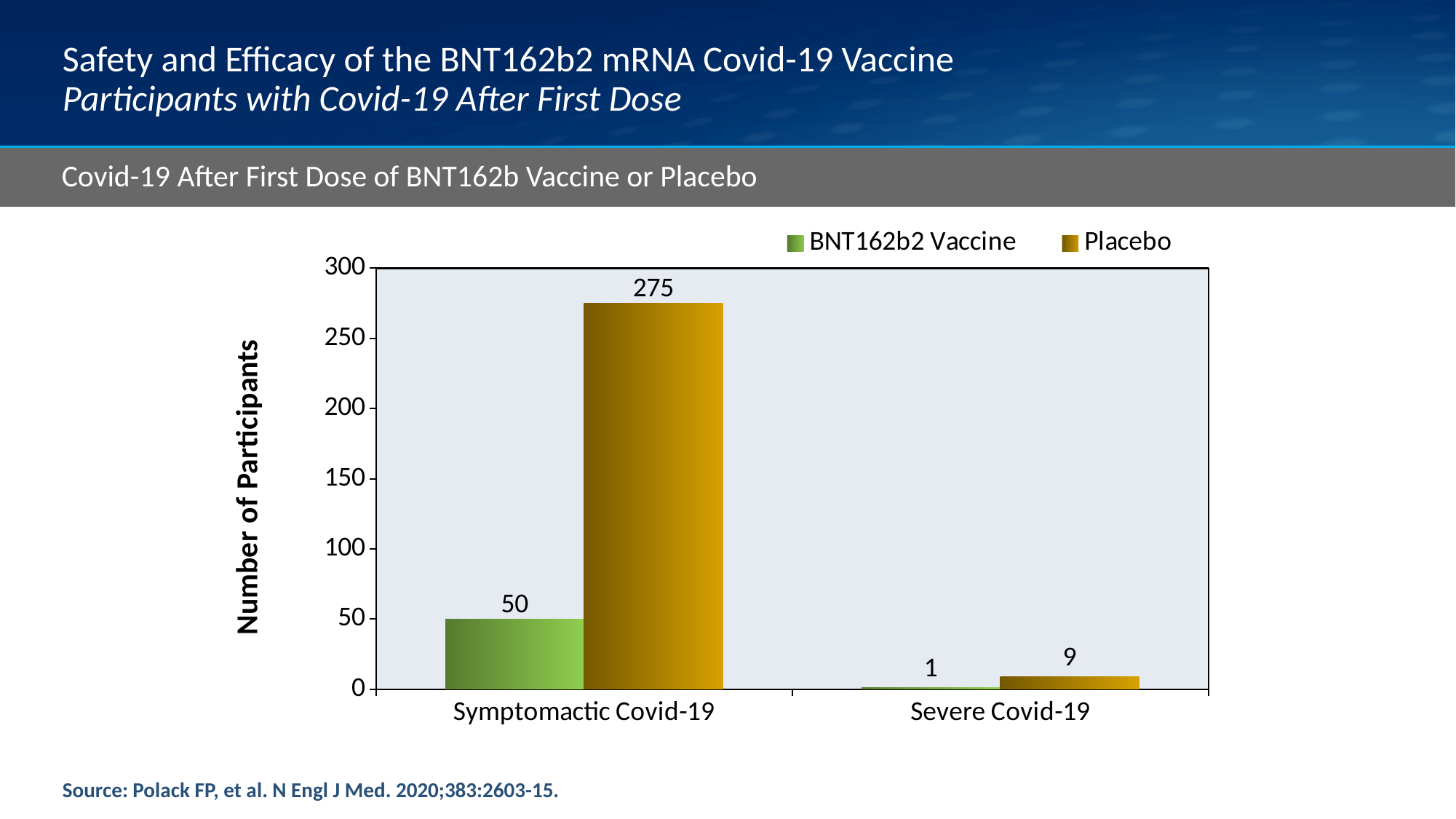
What is the number of participants with Symptomactic Covid-19 in the BNT162b2 Vaccine group? 50 What is the difference between the Placebo and BNT162b2 Vaccine values for Severe Covid-19? 8 What is the number of participants with Severe Covid-19 in the Placebo group? 9 How many categories are shown on the x axis? 2 Is the Placebo value for Symptomactic Covid-19 greater or less than 250? greater Which group has the highest number of participants with Symptomactic Covid-19? Placebo What is the difference between the Placebo and BNT162b2 Vaccine values for Symptomactic Covid-19? 225 What is the number of participants with Symptomactic Covid-19 in the Placebo group? 275 How many series does the legend list? 2 Which bar shows the lowest value on the chart? BNT162b2 Vaccine, Severe Covid-19 What is the number of participants with Severe Covid-19 in the BNT162b2 Vaccine group? 1 What kind of chart is shown on the slide? Bar chart